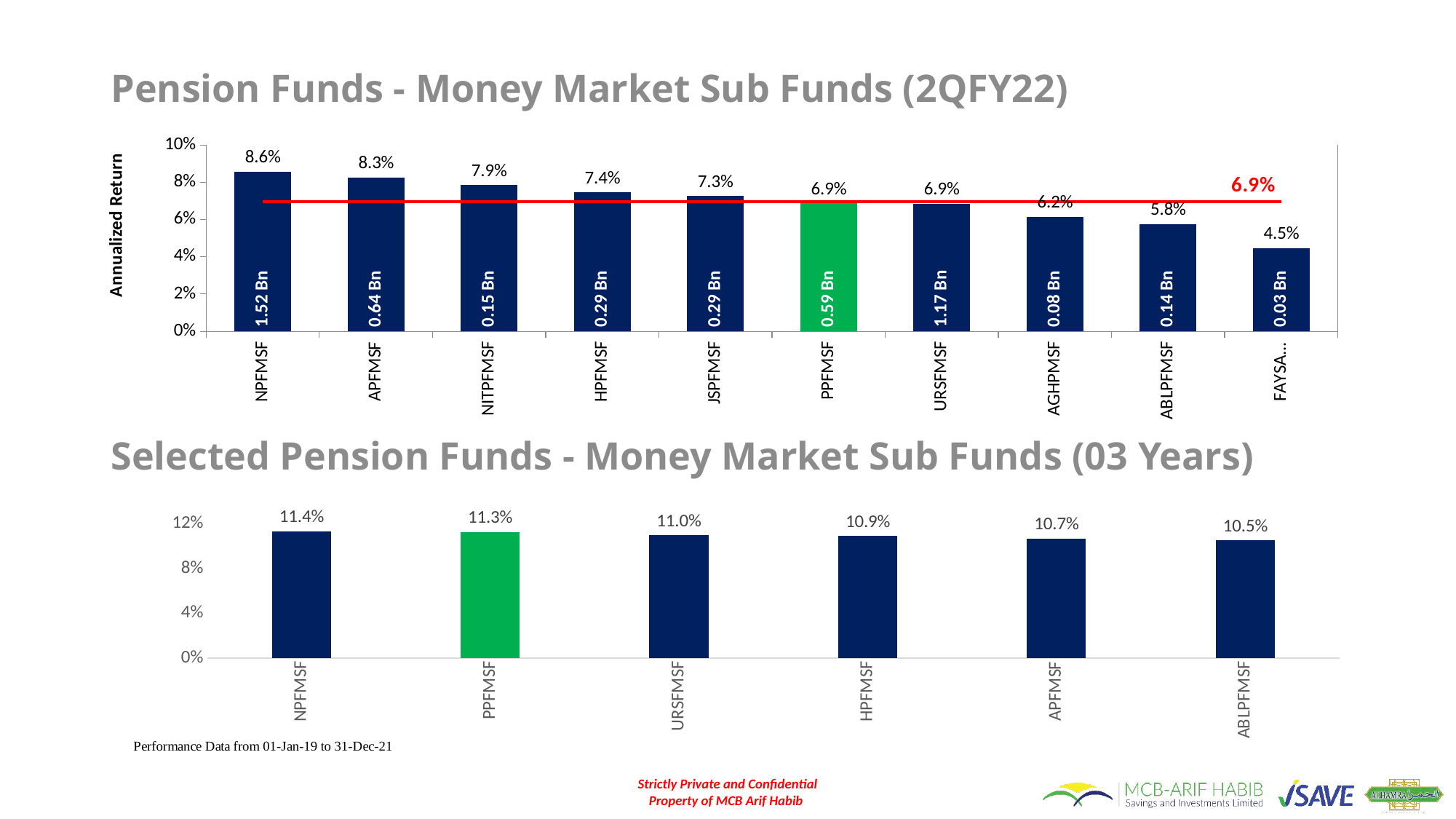
In the 'Pension Funds - Money Market Sub Funds (2QFY22)' chart, which fund has the highest annualized return? NPFMSF In the 'Pension Funds - Money Market Sub Funds (2QFY22)' chart, what value is labelled on the red horizontal line? 6.9% In the 'Selected Pension Funds - Money Market Sub Funds (03 Years)' chart, how many funds are plotted? 6 In the 'Pension Funds - Money Market Sub Funds (2QFY22)' chart, what is the annualized return for NITPFMSF? 7.9% In the 'Selected Pension Funds - Money Market Sub Funds (03 Years)' chart, which fund has the lowest return? ABLPFMSF What type of chart is the 'Selected Pension Funds - Money Market Sub Funds (03 Years)' chart? Bar chart In the 'Pension Funds - Money Market Sub Funds (2QFY22)' chart, how many funds are plotted? 10 In the 'Selected Pension Funds - Money Market Sub Funds (03 Years)' chart, what is the return for URSFMSF? 11.0% In the 'Pension Funds - Money Market Sub Funds (2QFY22)' chart, which has the higher annualized return, APFMSF or HPFMSF? APFMSF In the 'Pension Funds - Money Market Sub Funds (2QFY22)' chart, what is the fund size label shown inside the PPFMSF bar? 0.59 Bn In the 'Pension Funds - Money Market Sub Funds (2QFY22)' chart, what is the difference between the annualized returns of NPFMSF and ABLPFMSF? 2.8% In the 'Selected Pension Funds - Money Market Sub Funds (03 Years)' chart, what is the difference between the returns of NPFMSF and APFMSF? 0.7%